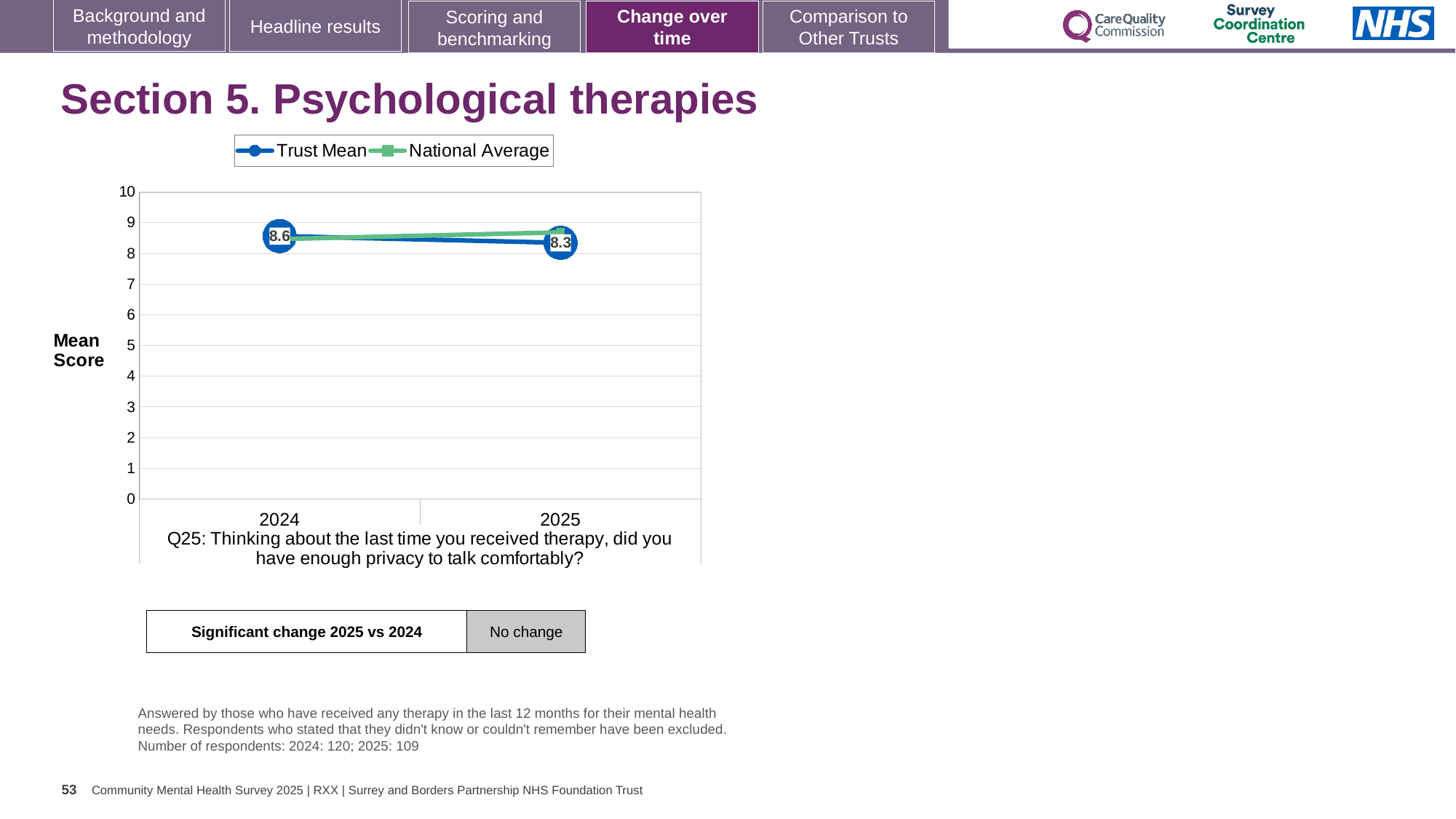
How many years are shown on the x axis of the chart? 2 Does the Trust Mean score rise or fall from 2024 to 2025? fall In which year is the Trust Mean score lowest? 2025 Is the National Average value for 2024 greater or less than 7? greater What kind of chart is shown on the slide? line chart How many series does the chart legend list? 2 By how much did the Trust Mean score change from 2024 to 2025? 0.3 Which year has the higher Trust Mean score, 2024 or 2025? 2024 What is the Trust Mean score for 2025? 8.3 Is the National Average value for 2025 greater or less than 8? greater What is the Trust Mean score for 2024? 8.6 What is the label on the y axis of the chart? Mean Score